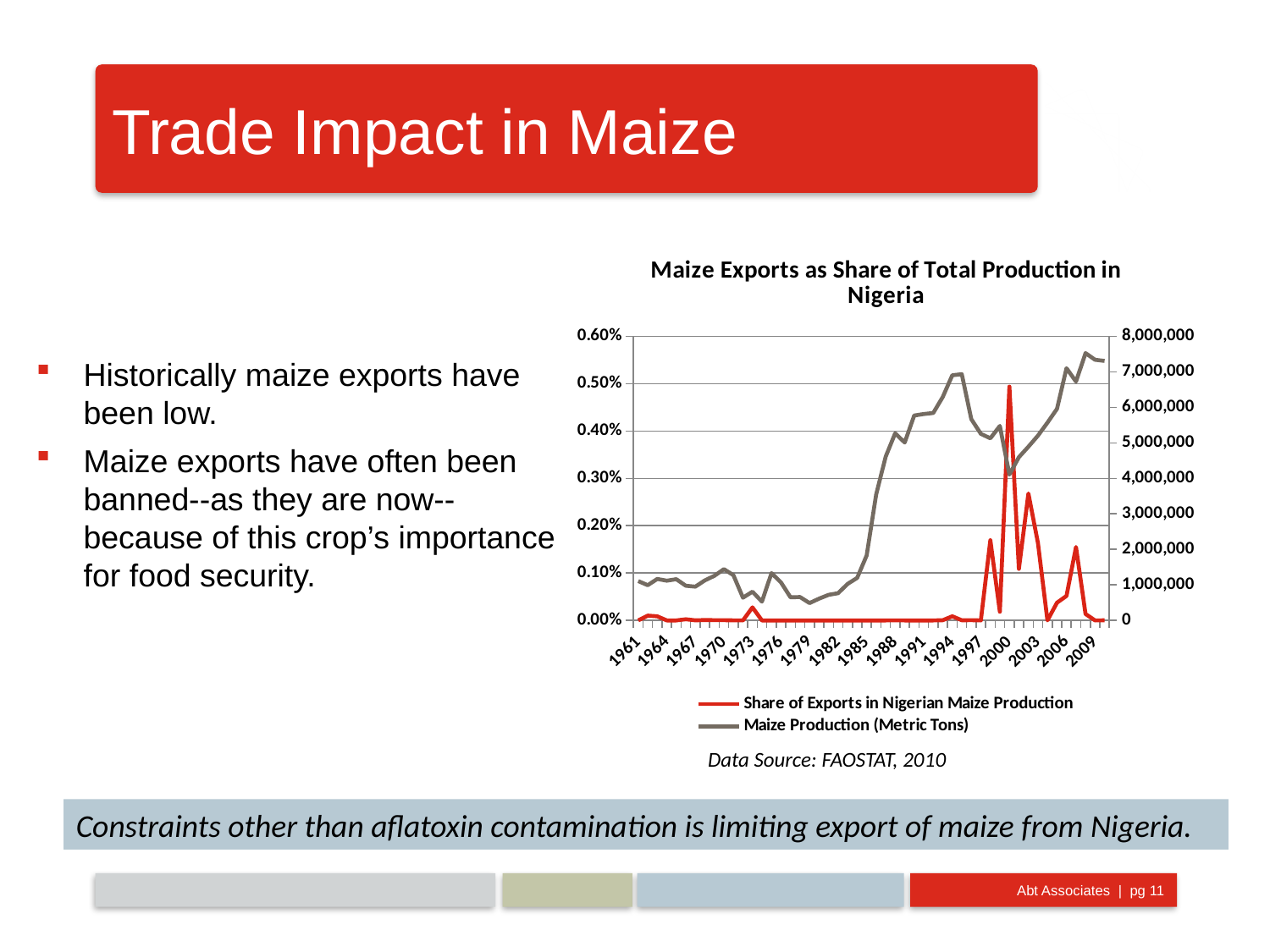
Does Maize Production rise or fall between 1985 and 1994? rise How many series does the legend list? 2 Which is larger, the Share of Exports in Nigerian Maize Production in 2000 or in 2003? 2000 In which year does the Share of Exports in Nigerian Maize Production reach its highest value? 2000 Is the Share of Exports in Nigerian Maize Production for 1973 greater or less than 0.10%? less Is the Maize Production value for 1994 greater or less than 6,000,000? greater Is the Maize Production value for 2009 greater or less than 7,000,000? greater What is the title of the chart? Maize Exports as Share of Total Production in Nigeria What kind of chart is shown on the slide? Line chart Which series is drawn in red? Share of Exports in Nigerian Maize Production